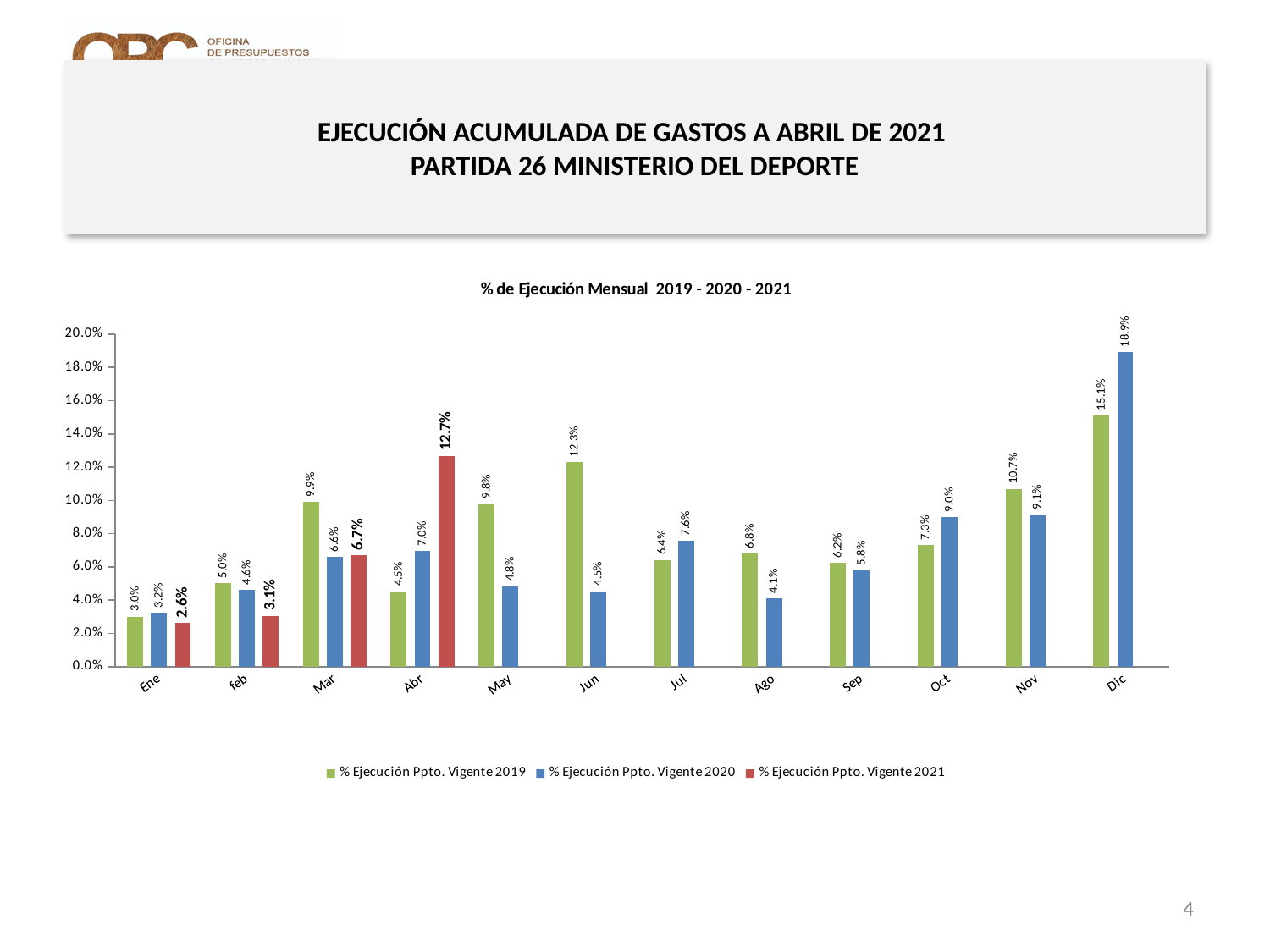
What is the value for % Ejecución Ppto. Vigente 2020 in Dic? 18.9% What is the difference between the 2021 and 2019 values in Abr? 8.2% How many series does the legend list? 3 In which month is the % Ejecución Ppto. Vigente 2020 series lowest? Ene Which is larger in Mar: the 2019 value or the 2020 value? 2019 (9.9%) How many months are shown on the x axis? 12 What colour represents the % Ejecución Ppto. Vigente 2021 series? Red What is the value for % Ejecución Ppto. Vigente 2021 in Abr? 12.7% What is the value for % Ejecución Ppto. Vigente 2019 in Jun? 12.3% What kind of chart is shown on the slide? Bar chart What is the value for % Ejecución Ppto. Vigente 2021 in Ene? 2.6% In which month is the % Ejecución Ppto. Vigente 2019 series highest? Dic